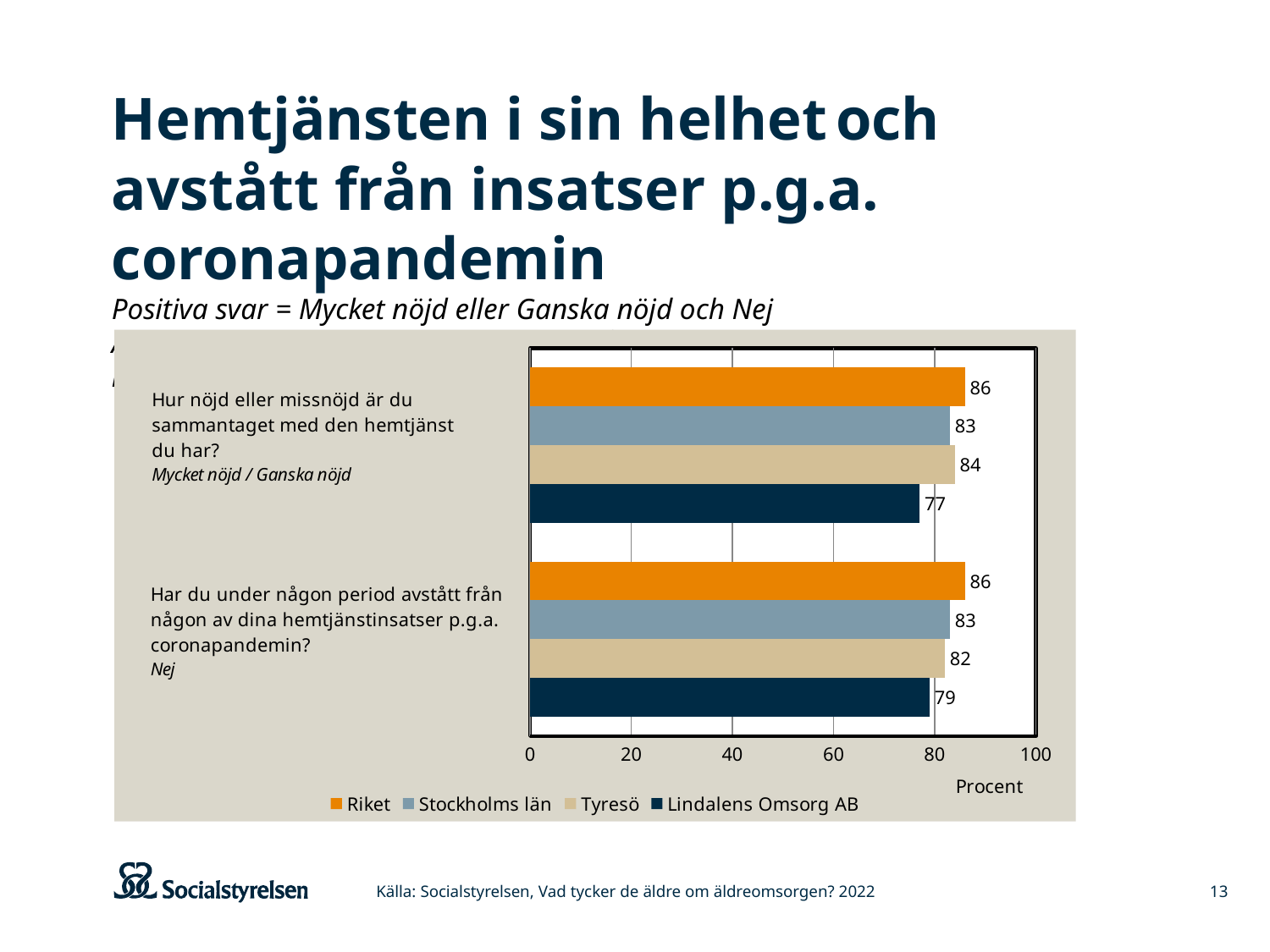
What is the difference between Riket and Lindalens Omsorg AB on the question "Hur nöjd eller missnöjd är du sammantaget med den hemtjänst du har?"? 9 How many series does the legend list? 4 What is the difference between Tyresö and Lindalens Omsorg AB on the question "Har du under någon period avstått från någon av dina hemtjänstinsatser p.g.a. coronapandemin?"? 3 What kind of chart is shown on the slide? Bar chart What value is shown for Stockholms län on the question "Har du under någon period avstått från någon av dina hemtjänstinsatser p.g.a. coronapandemin?"? 83 Which series has the highest value on the question "Har du under någon period avstått från någon av dina hemtjänstinsatser p.g.a. coronapandemin?"? Riket What value is shown for Riket on the question "Hur nöjd eller missnöjd är du sammantaget med den hemtjänst du har?"? 86 What value is shown for Lindalens Omsorg AB on the question "Hur nöjd eller missnöjd är du sammantaget med den hemtjänst du har?"? 77 What value is shown for Tyresö on the question "Har du under någon period avstått från någon av dina hemtjänstinsatser p.g.a. coronapandemin?"? 82 What unit label is shown on the horizontal axis of the chart? Procent Which series has the lowest value on the question "Hur nöjd eller missnöjd är du sammantaget med den hemtjänst du har?"? Lindalens Omsorg AB Which is larger on the question "Hur nöjd eller missnöjd är du sammantaget med den hemtjänst du har?": Tyresö or Stockholms län? Tyresö